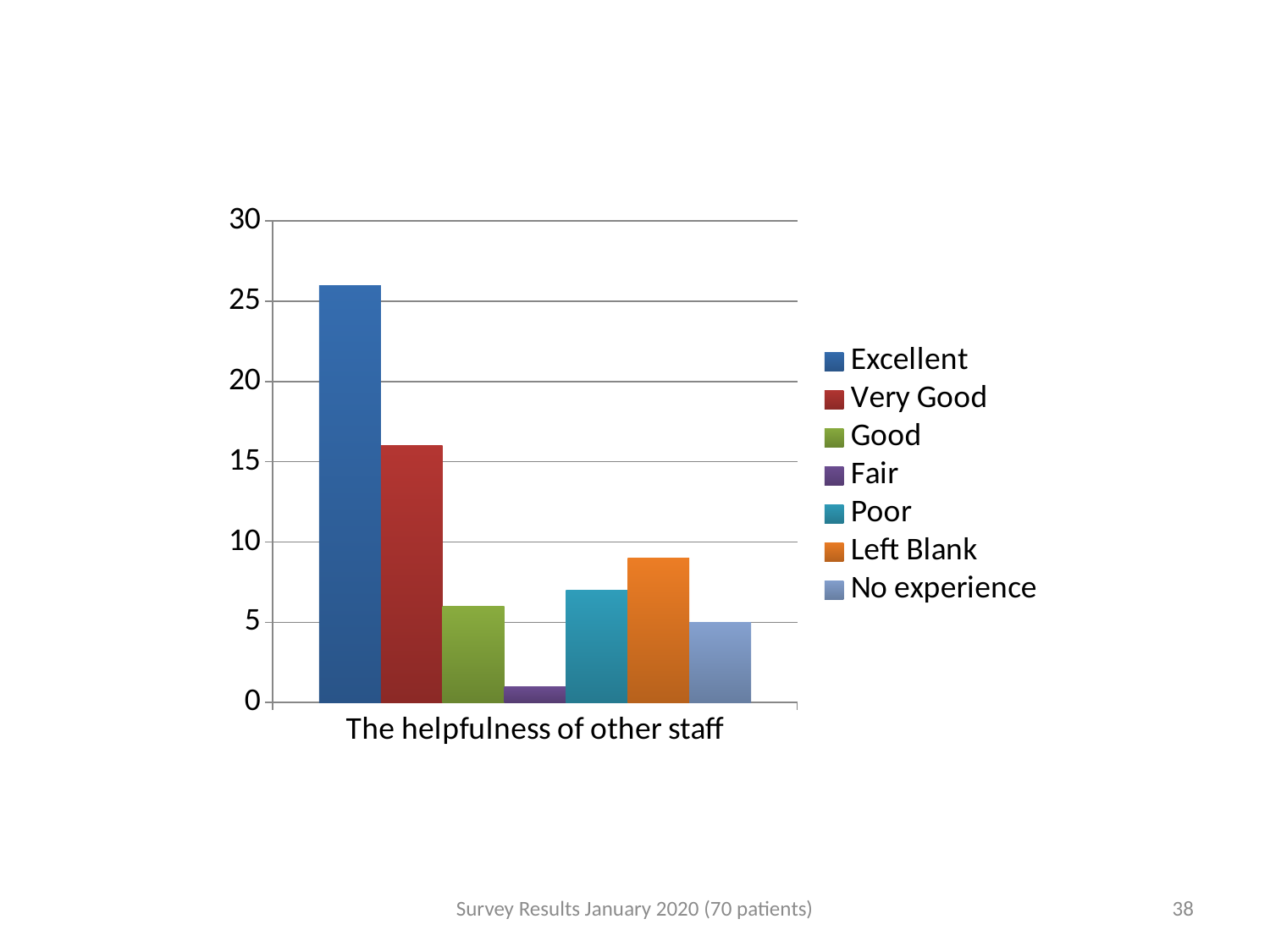
Which rating has the lowest bar? Fair Which rating has the highest bar? Excellent How many series does the legend list? 7 Which is larger, the value for Left Blank or the value for Good? Left Blank Is the value for Very Good greater or less than 20? less Is the value for Poor greater or less than 5? greater What is the category label shown beneath the bars on the x axis? The helpfulness of other staff How many bars are plotted in the chart? 7 What type of chart is shown on the slide? bar chart Which is larger, the value for Very Good or the value for Poor? Very Good